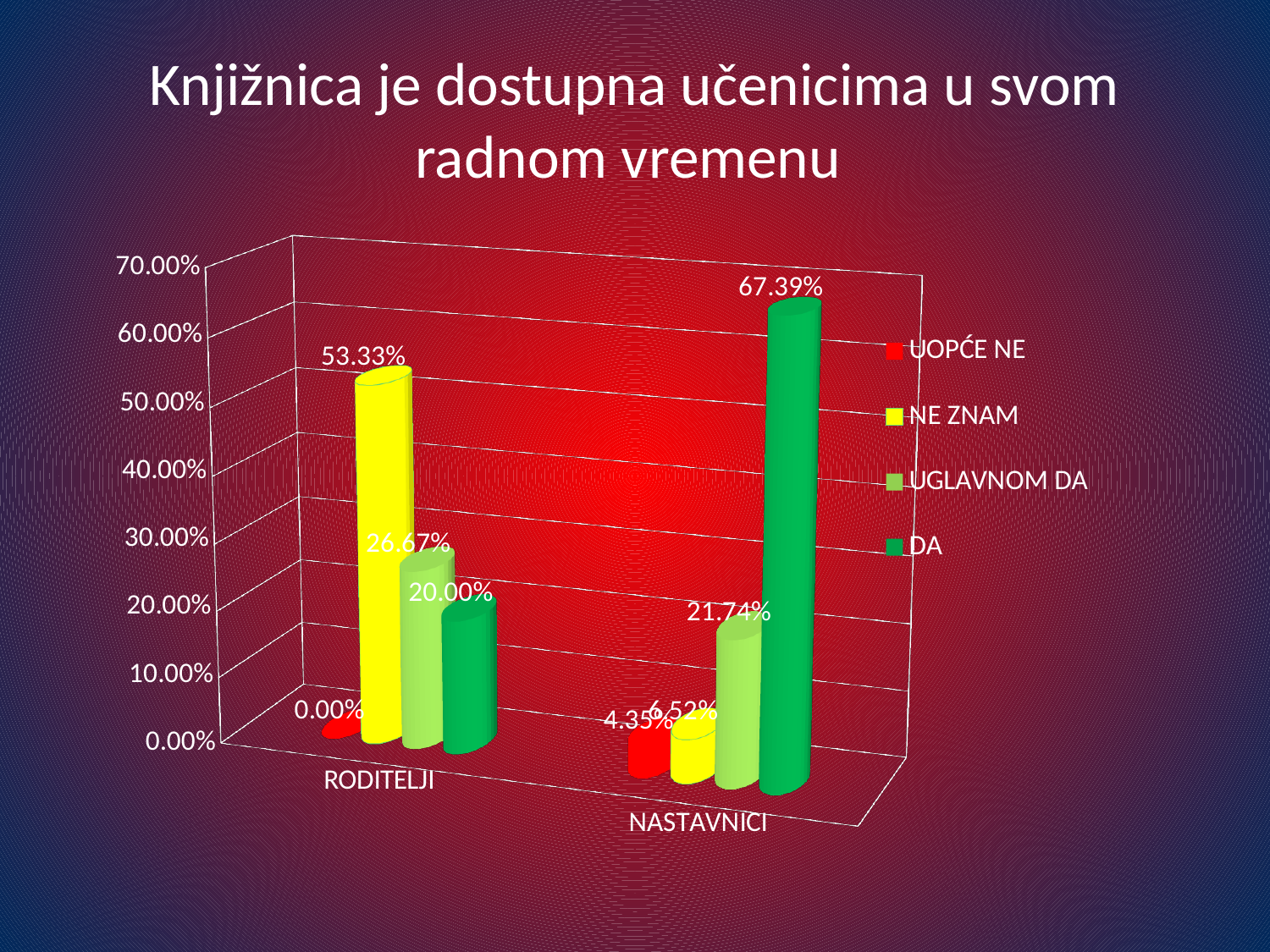
Which is larger: the NE ZNAM value for RODITELJI or the NE ZNAM value for NASTAVNICI? RODITELJI What is the value for DA in the NASTAVNICI category? 67.39% How many categories are shown on the x axis? 2 What kind of chart is shown on the slide? Bar chart How many series does the legend list? 4 What is the difference between the DA value for NASTAVNICI and the DA value for RODITELJI? 47.39% Which series has the highest value in the NASTAVNICI category? DA Which series has the lowest value in the RODITELJI category? UOPĆE NE What is the value for NE ZNAM in the RODITELJI category? 53.33% What is the value for UGLAVNOM DA in the NASTAVNICI category? 21.74% What colour represents the DA series in the legend? Dark green What is the value for UOPĆE NE in the RODITELJI category? 0.00%